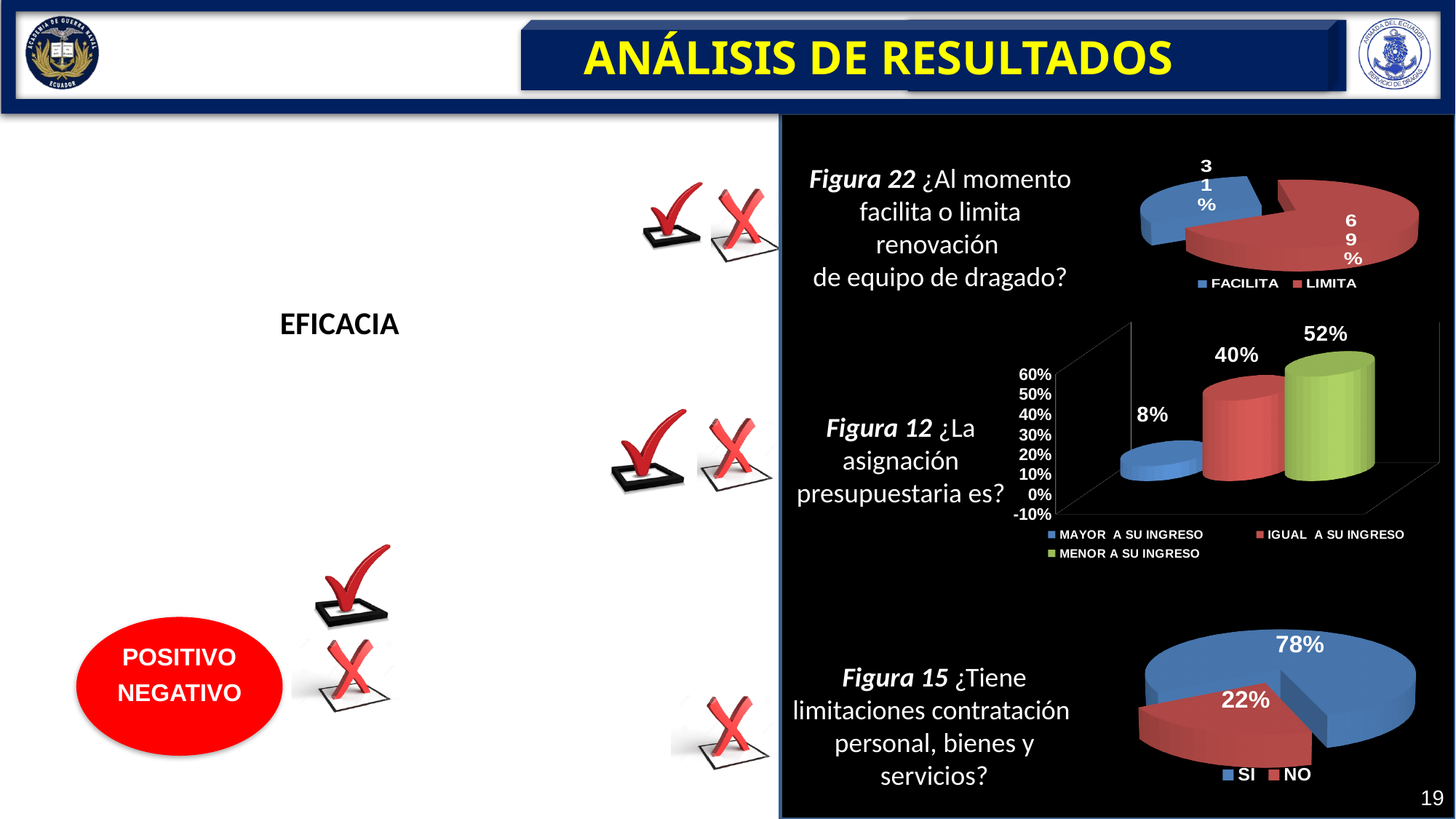
In the Figura 12 bar chart, what is the difference between MENOR A SU INGRESO and MAYOR A SU INGRESO? 44% In the Figura 22 pie chart, which category has the larger share, FACILITA or LIMITA? LIMITA How many series does the legend of the Figura 22 chart list? 2 In the Figura 12 bar chart, what is the value for IGUAL A SU INGRESO? 40% In the Figura 22 pie chart, what share is labelled for FACILITA? 31% What kind of chart is Figura 12? bar chart How many bars are shown in the Figura 12 chart? 3 In the Figura 22 pie chart, what share is labelled for LIMITA? 69% In the Figura 12 bar chart, which category has the highest value? MENOR A SU INGRESO In the Figura 15 pie chart, what is the difference between the SI and NO shares? 56% In the Figura 15 pie chart, what share is labelled for SI? 78% In the Figura 12 bar chart, which category has the lowest value? MAYOR A SU INGRESO